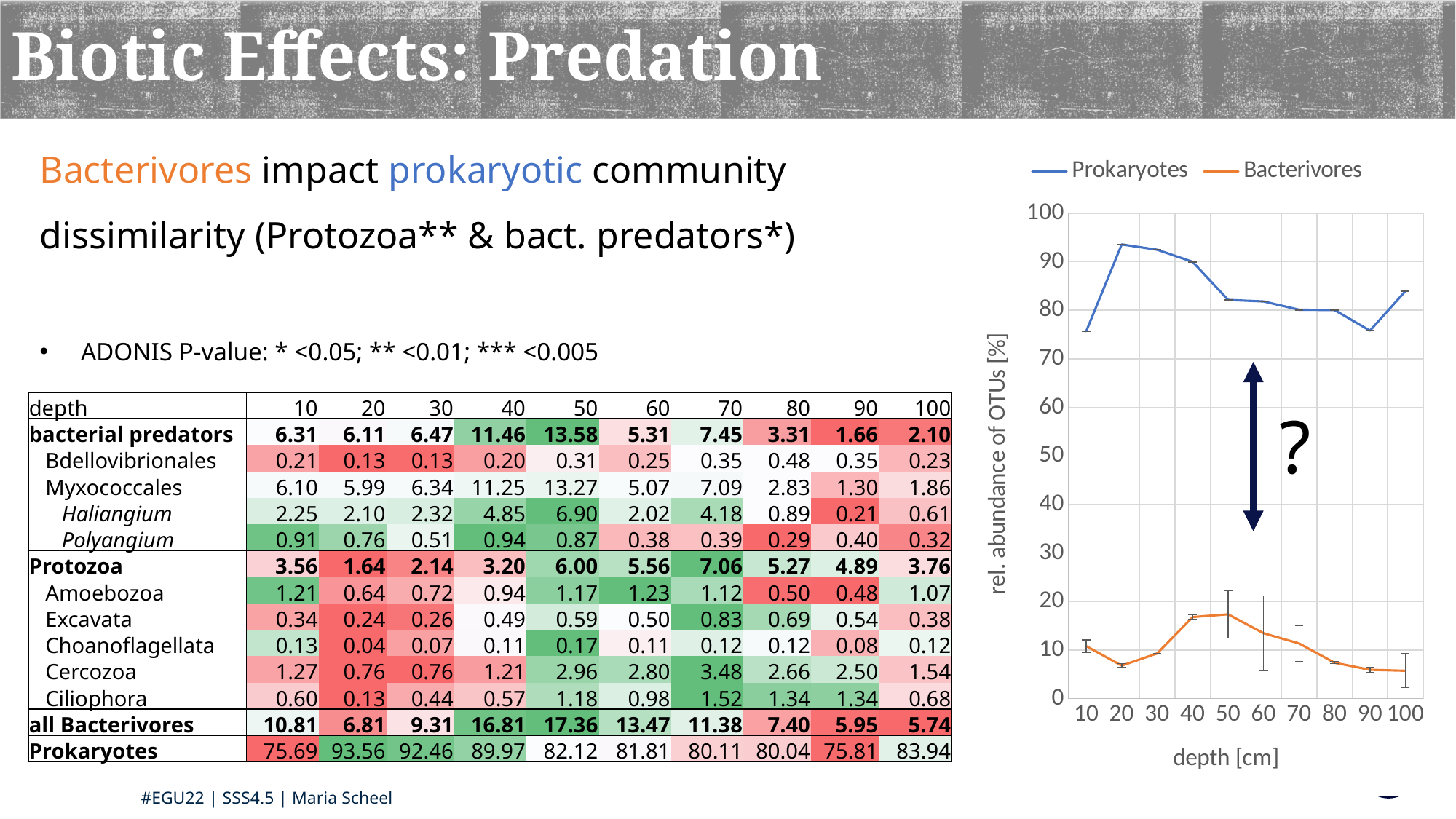
Is the Prokaryotes value at depth 10 greater or less than 80? less Is the Prokaryotes value at depth 20 greater or less than 90? greater How many series does the legend of the line chart list? 2 Which is larger for Bacterivores: the value at depth 40 or at depth 80? depth 40 At which depth does the Prokaryotes line reach its highest value? 20 Which is larger for Prokaryotes: the value at depth 20 or at depth 50? depth 20 How many depth points are plotted for each series in the line chart? 10 Is the Bacterivores value at depth 100 greater or less than 10? less Does the Bacterivores line rise or fall from depth 50 to depth 100? fall What kind of chart is shown on the right of the slide? line chart What is the y-axis title of the line chart? rel. abundance of OTUs [%]